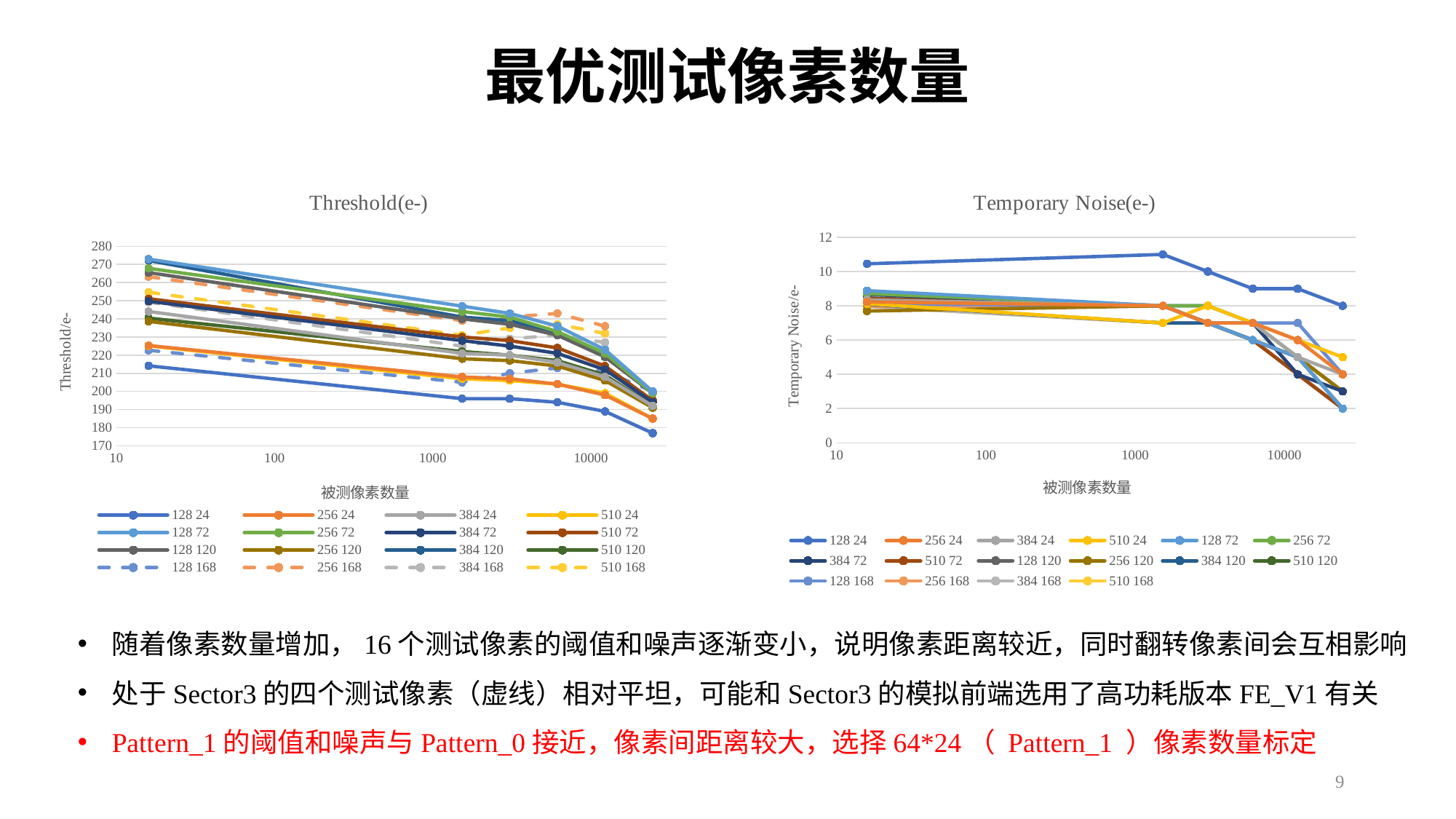
In the Threshold(e-) chart, which series has the lowest values across the x axis? 128 24 What kind of chart is the Threshold(e-) chart? line chart What is the x-axis title of the Threshold(e-) chart? 被测像素数量 In the Temporary Noise(e-) chart, is the leftmost value of the 128 24 series greater or less than 10? greater In the Temporary Noise(e-) chart, at the leftmost x position, which series has the larger value: 128 24 or 256 24? 128 24 In the Temporary Noise(e-) chart, which series has the highest values across the x axis? 128 24 How many series does the legend of the Threshold(e-) chart list? 16 In the Threshold(e-) chart, do the values of the 128 24 series rise or fall as the number of pixels on the x axis increases? fall How many series does the legend of the Temporary Noise(e-) chart list? 16 What kind of chart is the Temporary Noise(e-) chart? line chart In the Threshold(e-) chart, at the leftmost x position, which series has the larger value: 128 24 or 128 72? 128 72 In the Threshold(e-) chart, is the leftmost value of the 128 24 series greater or less than 220? less